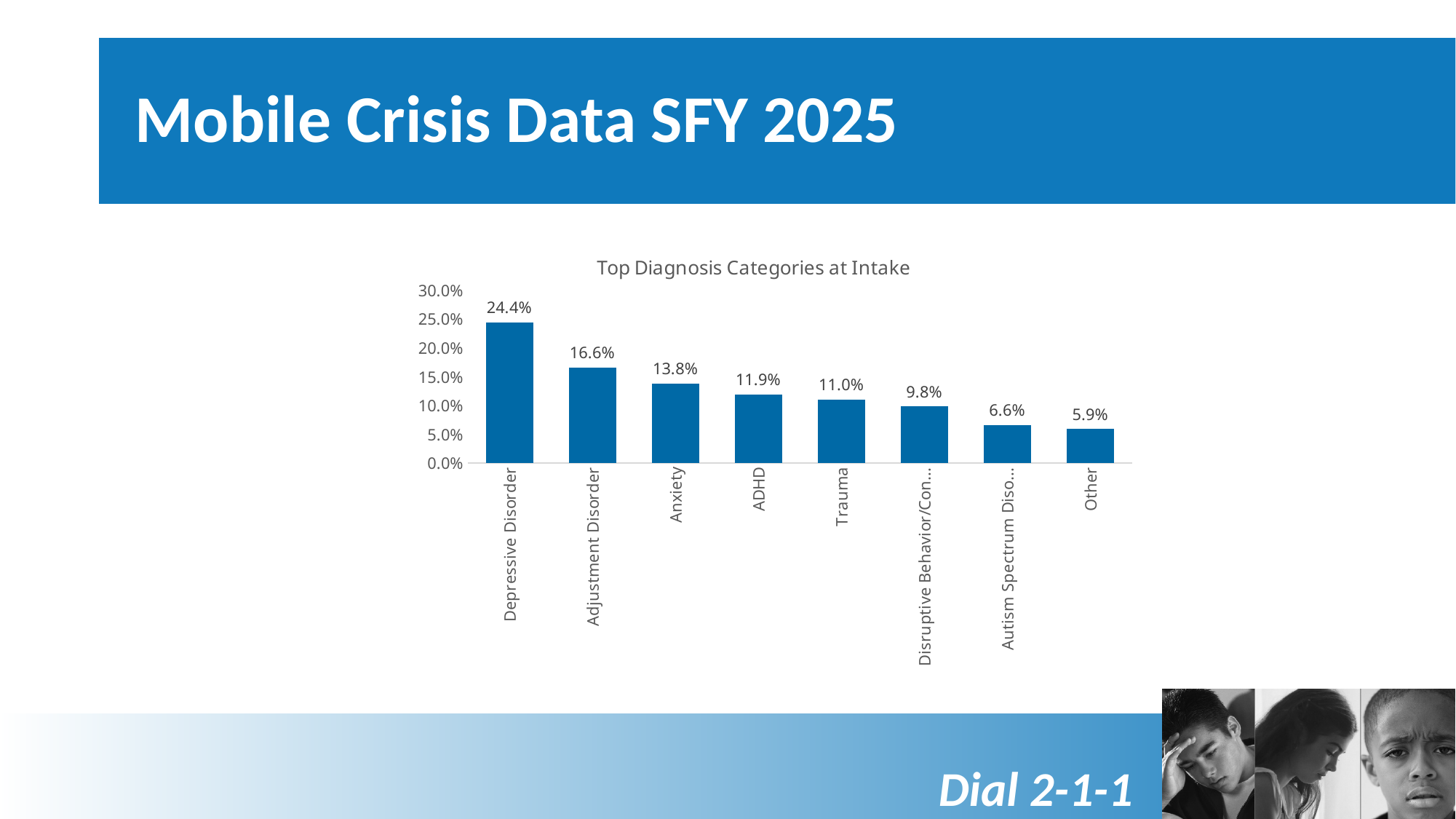
Which category has the highest value? Depressive Disorder Which category has the lowest value? Other What is the value for Anxiety? 13.8% What is the difference between Depressive Disorder and Adjustment Disorder? 7.8% How many categories are shown in the chart? 8 What is the value for Trauma? 11.0% What is the value for Depressive Disorder? 24.4% What is the value for Other? 5.9% Is the value for Adjustment Disorder greater or less than 15.0%? greater What kind of chart is shown on the slide? Bar chart What is the difference between ADHD and Trauma? 0.9% Which is larger, Anxiety or ADHD? Anxiety